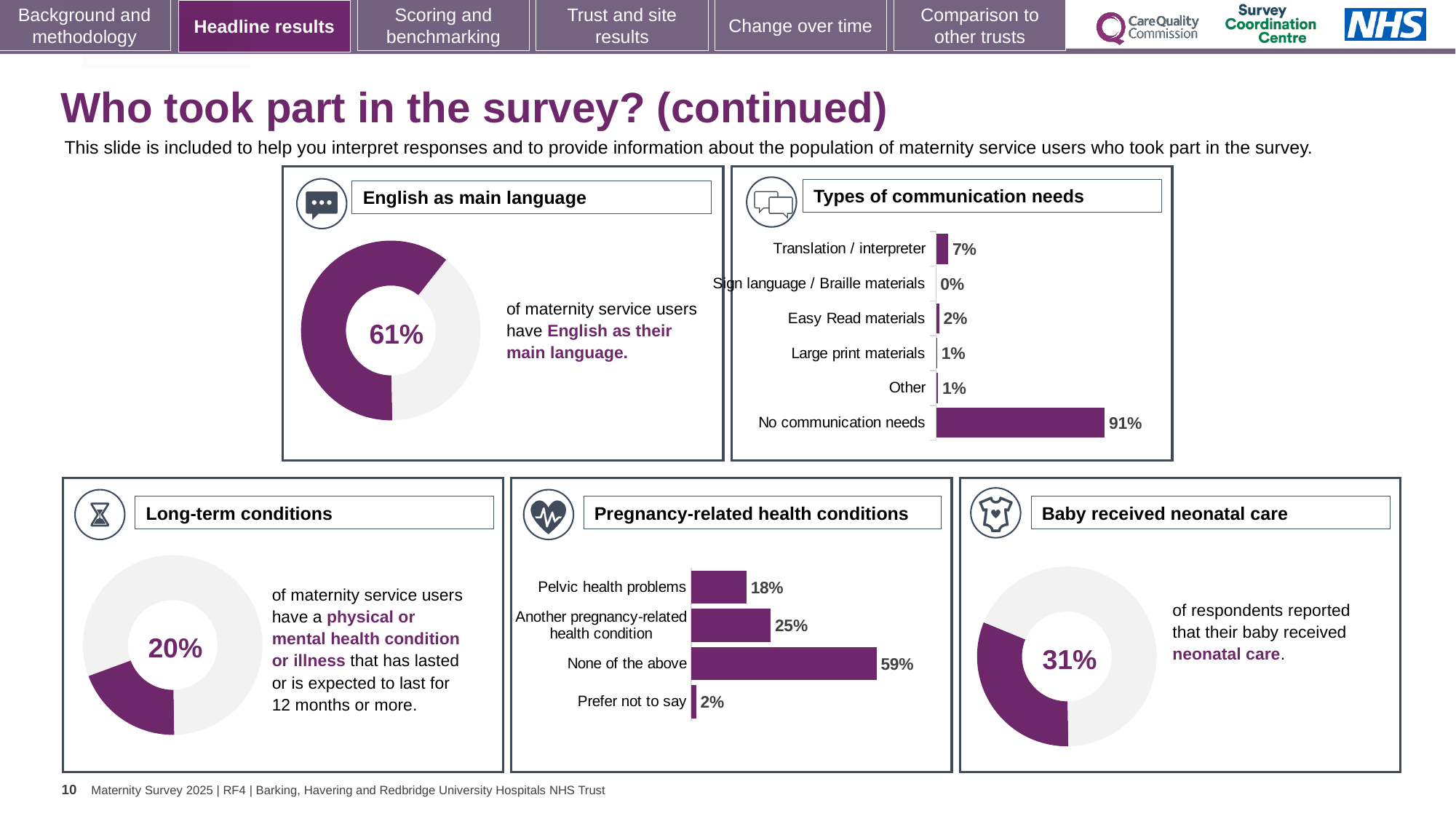
In the 'Types of communication needs' chart, what is the difference between No communication needs and Translation / interpreter? 84% In the 'Types of communication needs' chart, how many categories are shown? 6 In the 'Pregnancy-related health conditions' chart, which is larger: Pelvic health problems or Another pregnancy-related health condition? Another pregnancy-related health condition In the 'Baby received neonatal care' chart, what percentage of respondents reported that their baby received neonatal care? 31% In the 'Types of communication needs' chart, which category has the highest value? No communication needs In the 'Pregnancy-related health conditions' chart, what is the value for Pelvic health problems? 18% In the 'Pregnancy-related health conditions' chart, what kind of chart is used? Bar chart In the 'Types of communication needs' chart, what is the value for Translation / interpreter? 7% In the 'English as main language' chart, what percentage of maternity service users have English as their main language? 61% In the 'Long-term conditions' chart, what percentage of maternity service users have a physical or mental health condition or illness? 20% In the 'Types of communication needs' chart, which category has the lowest value? Sign language / Braille materials In the 'Pregnancy-related health conditions' chart, what is the difference between None of the above and Another pregnancy-related health condition? 34%